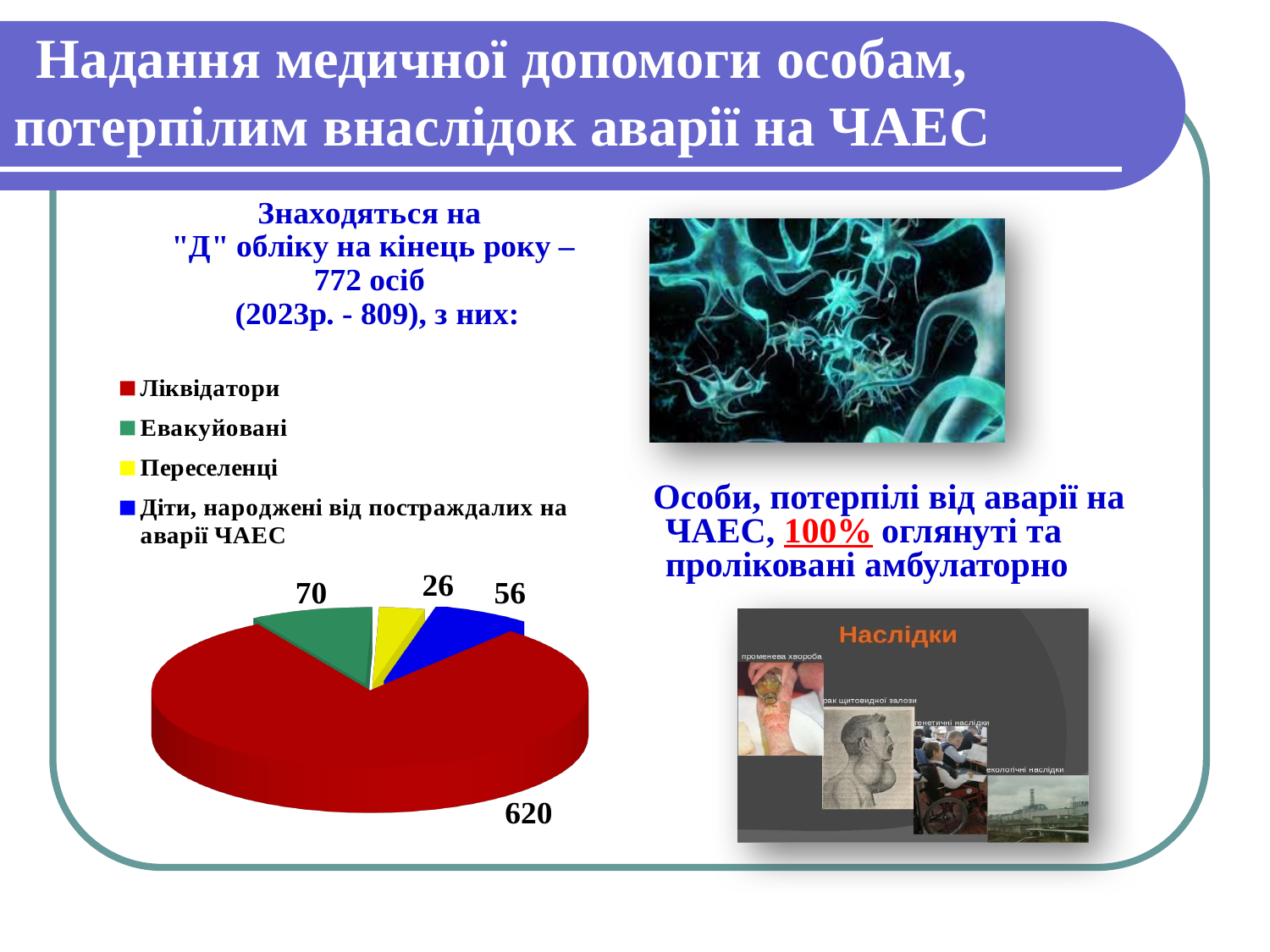
What is the value for Евакуйовані in the pie chart? 70 How many slices does the pie chart have? 4 What kind of chart is shown on the slide? pie chart Which category has the smallest slice in the pie chart? Переселенці What is the difference between the values for Евакуйовані and Діти, народжені від постраждалих на аварії ЧАЕС? 14 Which category has the largest slice in the pie chart? Ліквідатори What is the value for Переселенці in the pie chart? 26 What is the value for Діти, народжені від постраждалих на аварії ЧАЕС in the pie chart? 56 What colour is the Ліквідатори slice in the pie chart? red How many entries does the legend of the pie chart list? 4 What is the value for Ліквідатори in the pie chart? 620 Which is larger in the pie chart: Евакуйовані or Переселенці? Евакуйовані